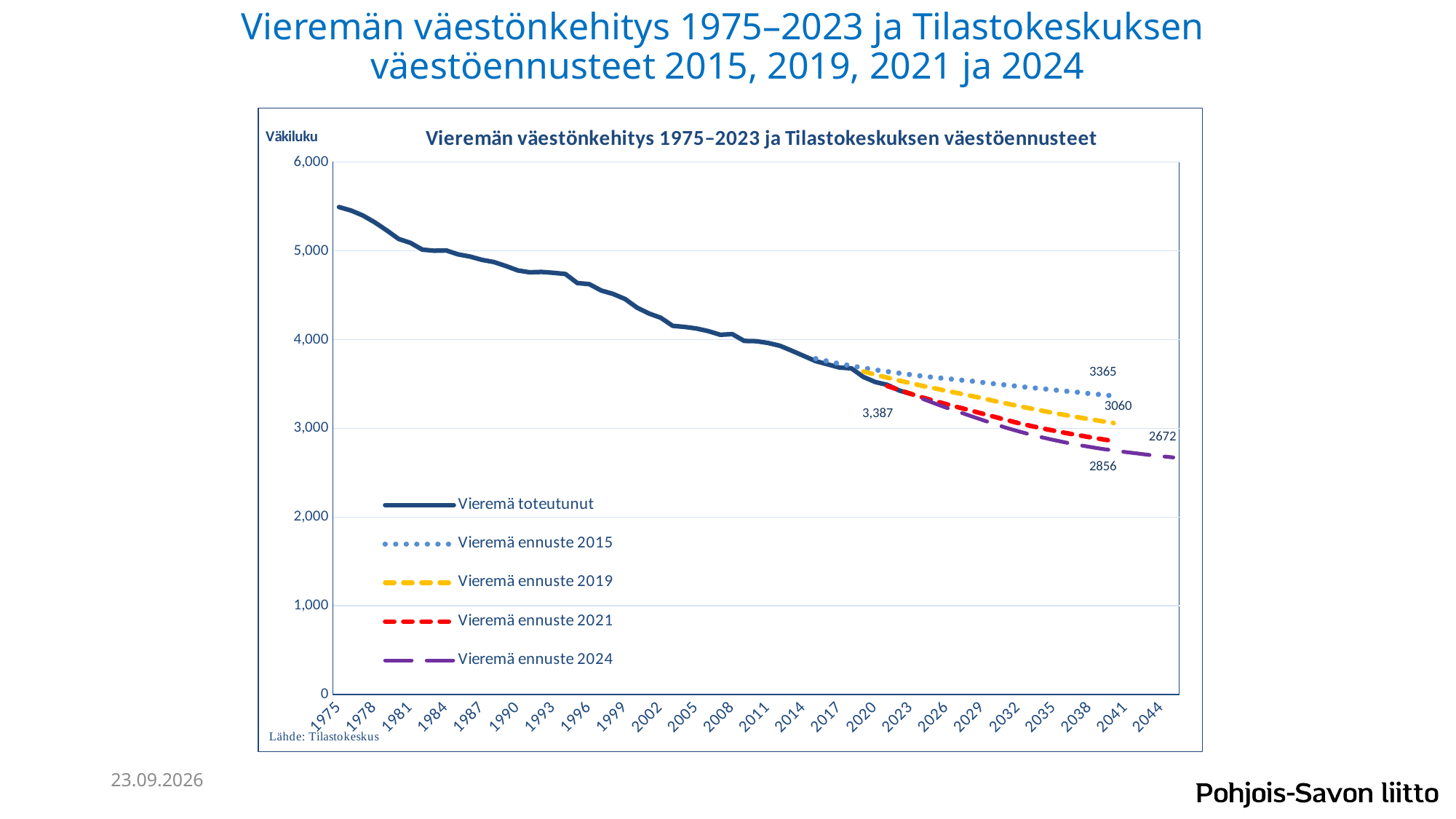
Which forecast series ends at the highest labelled value? Vieremä ennuste 2015 Is the Vieremä toteutunut value in 1975 greater or less than 5,000? greater What is the final labelled value of the Vieremä ennuste 2019 series? 3060 What is the difference between the final labelled values of Vieremä ennuste 2015 and Vieremä ennuste 2019? 305 Does the Vieremä toteutunut series rise or fall from 1975 to 2023? fall What is the labelled value at the end of the Vieremä toteutunut series? 3,387 Which forecast series ends at the lowest labelled value? Vieremä ennuste 2024 What is the final labelled value of the Vieremä ennuste 2021 series? 2856 What is the final labelled value of the Vieremä ennuste 2015 series? 3365 What kind of chart is shown on the slide? line chart How many series does the legend list? 5 What is the final labelled value of the Vieremä ennuste 2024 series? 2672